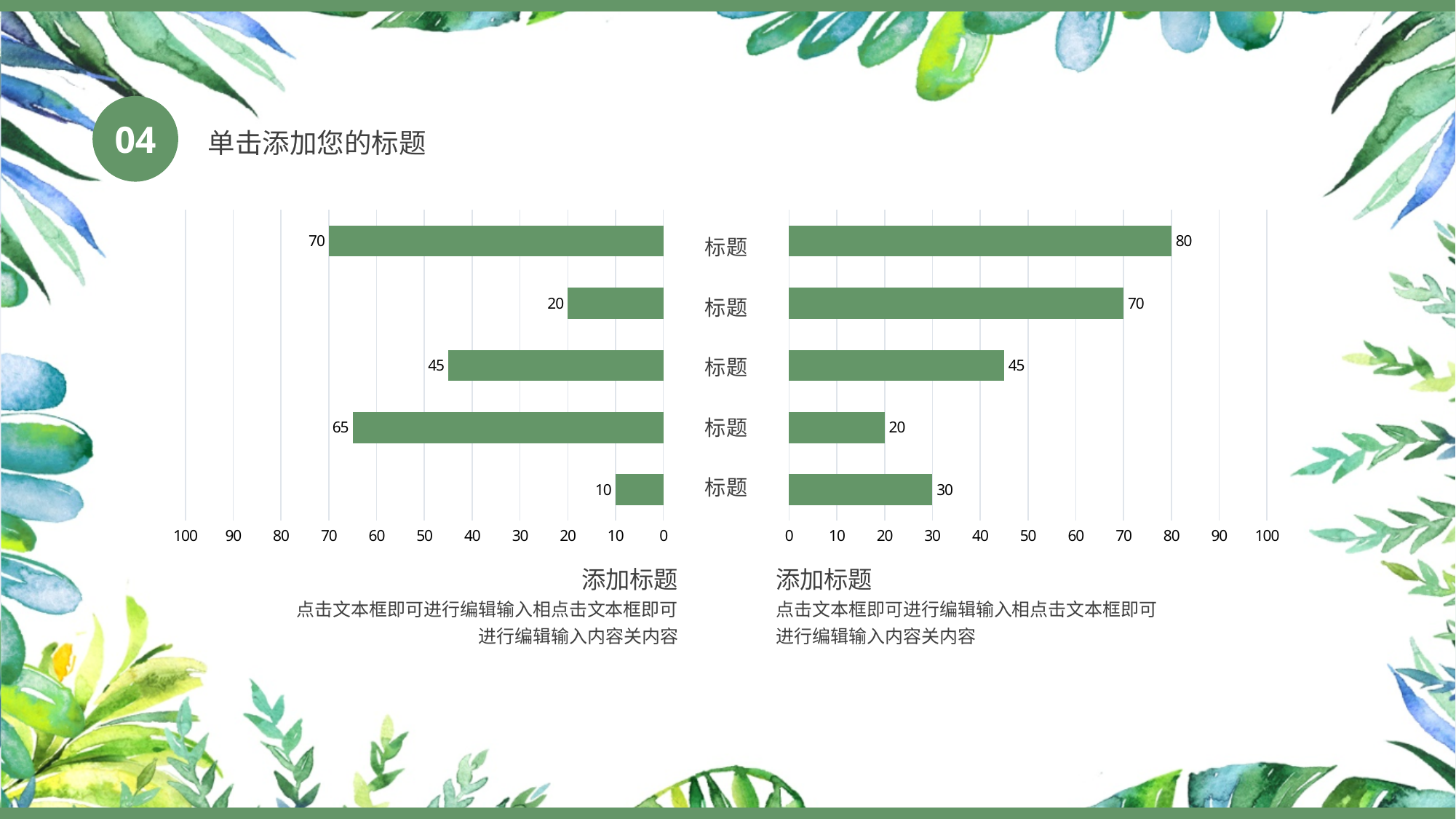
What is the maximum value shown on the x axis of the left chart? 100 In the right chart, what is the value of the fourth bar from the top? 20 What kind of chart is shown on the left side of the slide? bar chart In the left chart, what is the value of the top bar? 70 Which is larger: the top bar of the left chart or the top bar of the right chart? the top bar of the right chart (80) In the right chart, which bar has the lowest value? the fourth bar from the top (20) In the left chart, what is the difference between the fourth bar (65) and the bottom bar (10)? 55 How many bars does the right chart have? 5 In the right chart, what is the value of the top bar? 80 In the right chart, what is the difference between the top bar and the second bar? 10 In the left chart, which bar has the highest value? the top bar (70) In the left chart, what is the value of the bottom bar? 10